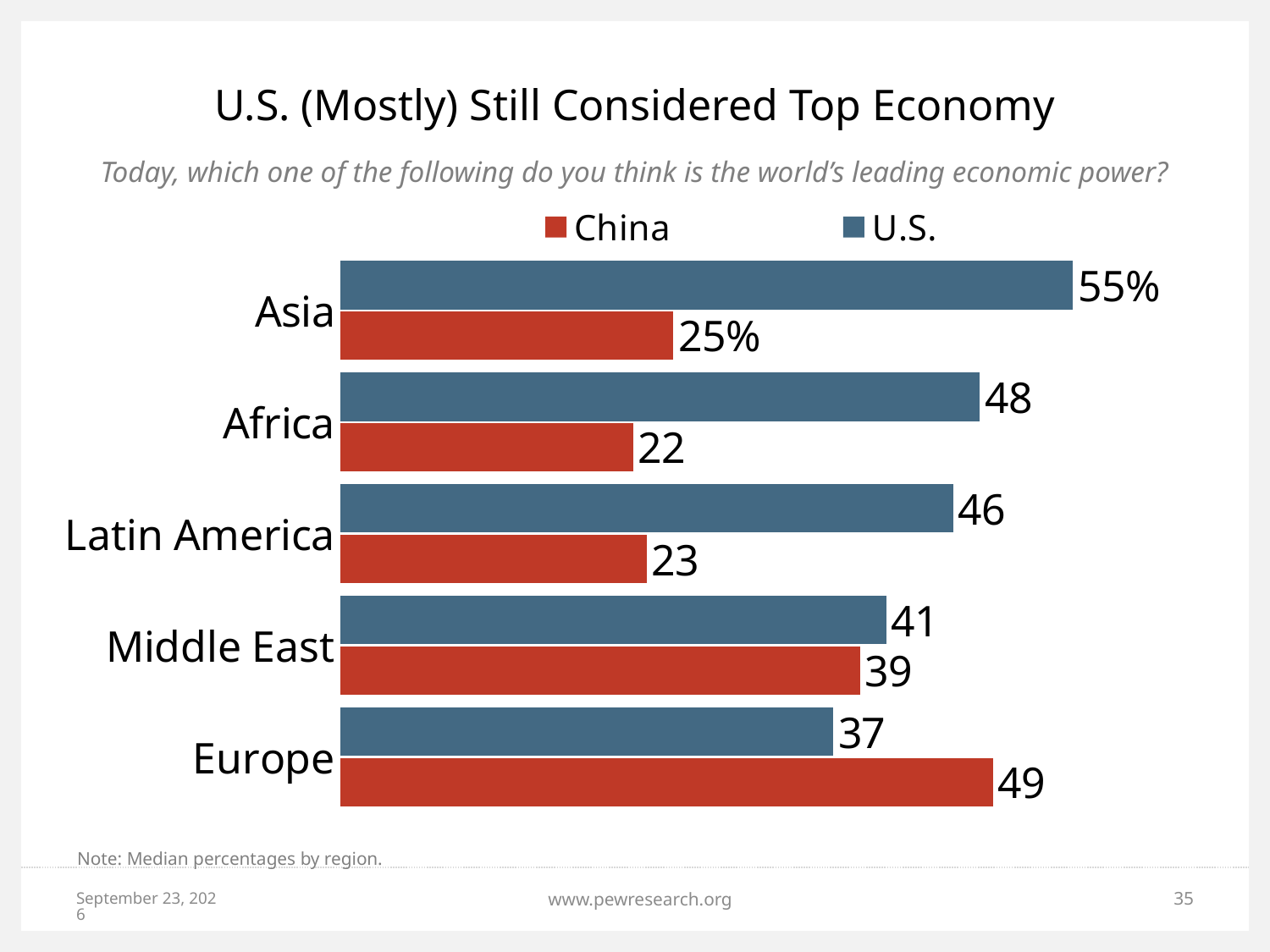
What is the difference between the U.S. and China values for Asia? 30 How many regions are shown in the chart? 5 Which is larger for Europe, the China value or the U.S. value? China What is the U.S. value for Asia? 55% Which colour represents China in the chart? Red Which region has the highest U.S. value? Asia What is the U.S. value for Latin America? 46 What is the China value for the Middle East? 39 How many series does the legend list? 2 What kind of chart is shown on the slide? Bar chart What is the China value for Europe? 49 Which region has the lowest China value? Africa